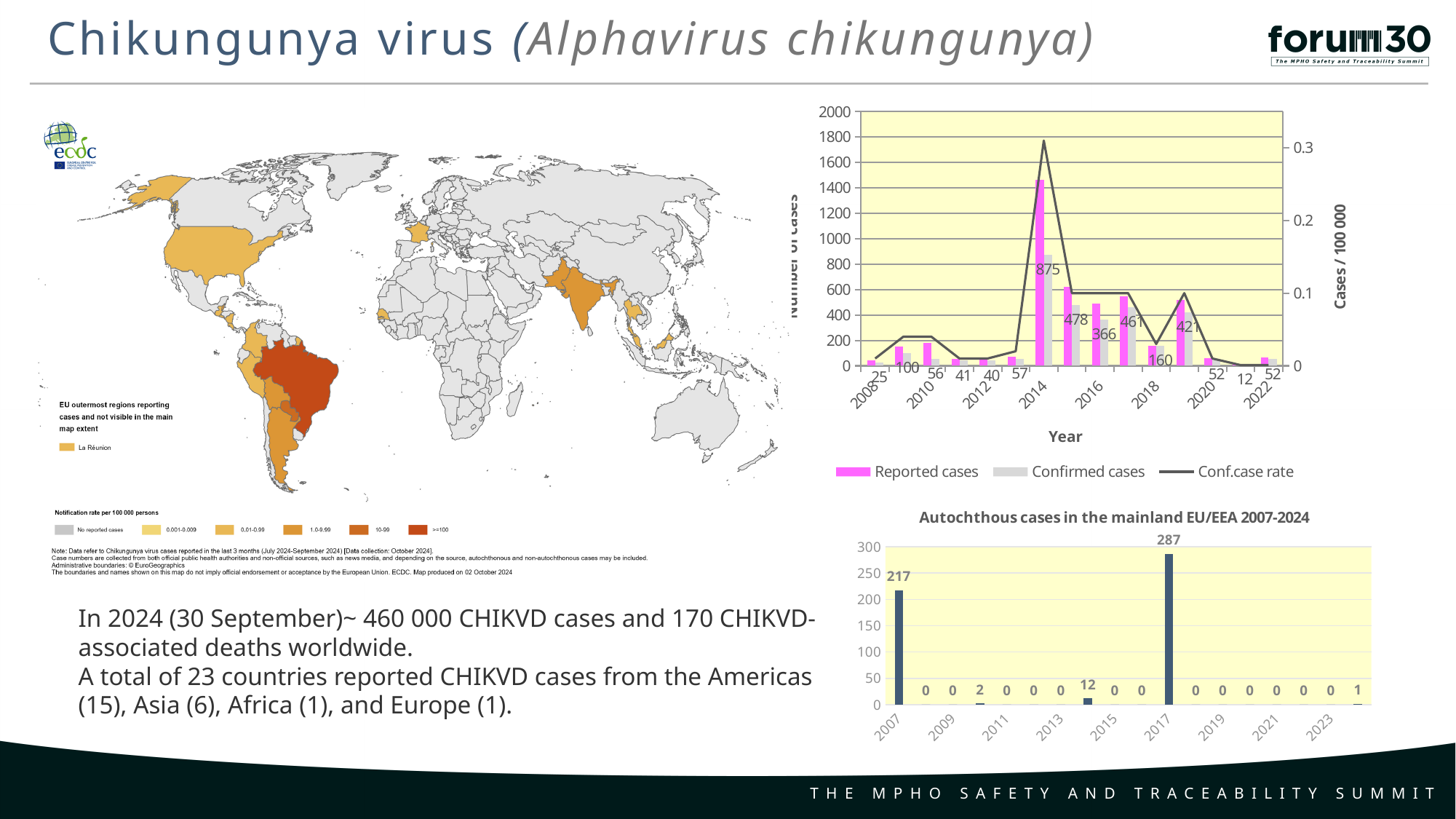
In the chart titled 'Autochthous cases in the mainland EU/EEA 2007-2024', how many cases were reported in 2014? 12 In the top-right chart of reported and confirmed cases by year, which year has more confirmed cases, 2015 or 2019? 2015 In the chart titled 'Autochthous cases in the mainland EU/EEA 2007-2024', how many years are plotted? 18 In the chart titled 'Autochthous cases in the mainland EU/EEA 2007-2024', which year has the highest number of cases? 2017 In the chart titled 'Autochthous cases in the mainland EU/EEA 2007-2024', how many autochthonous cases were reported in 2017? 287 In the top-right chart of reported and confirmed cases by year, what is the number of confirmed cases labelled for 2014? 875 What kind of chart is the 'Autochthous cases in the mainland EU/EEA 2007-2024' chart? bar chart In the chart titled 'Autochthous cases in the mainland EU/EEA 2007-2024', how many cases were reported in 2007? 217 In the chart titled 'Autochthous cases in the mainland EU/EEA 2007-2024', what is the difference between the cases in 2017 and in 2007? 70 In the top-right chart of reported and confirmed cases by year, is the value of reported cases for 2014 greater or less than 1200? greater In the top-right chart of reported and confirmed cases by year, what is the number of confirmed cases labelled for 2016? 366 In the top-right chart of reported and confirmed cases by year, how many series does the legend list? 3